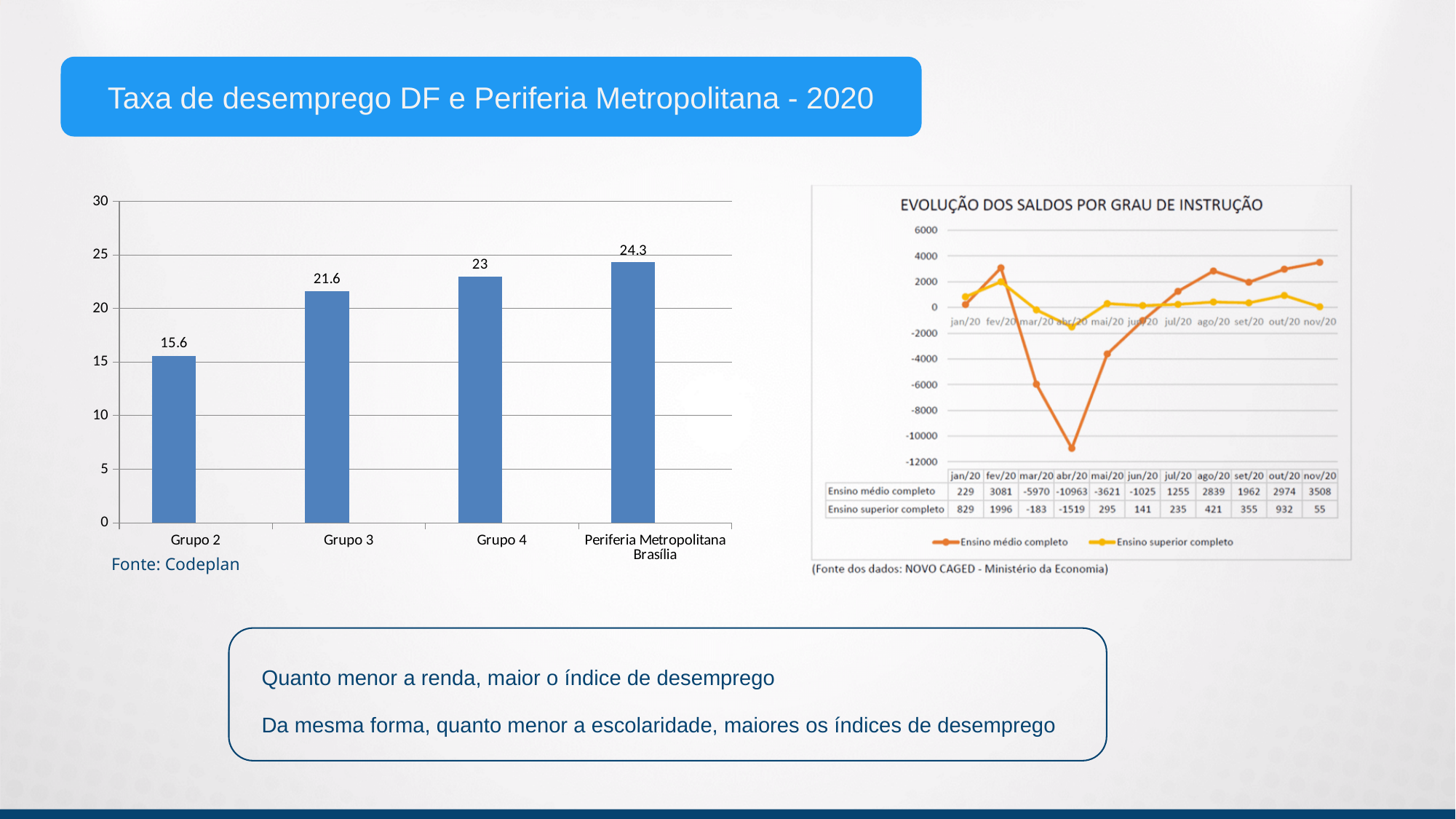
In the bar chart on the left, what is the difference between the values for Grupo 3 and Grupo 2? 6 In the chart titled 'EVOLUÇÃO DOS SALDOS POR GRAU DE INSTRUÇÃO', how many series does the legend list? 2 In the bar chart on the left, what is the value for Periferia Metropolitana Brasília? 24.3 In the chart titled 'EVOLUÇÃO DOS SALDOS POR GRAU DE INSTRUÇÃO', which series has the larger value in nov/20, Ensino médio completo or Ensino superior completo? Ensino médio completo In the chart titled 'EVOLUÇÃO DOS SALDOS POR GRAU DE INSTRUÇÃO', what is the value for Ensino superior completo in out/20? 932 In the bar chart on the left, which category has the lowest value? Grupo 2 In the bar chart on the left, which category has the highest value? Periferia Metropolitana Brasília In the chart titled 'EVOLUÇÃO DOS SALDOS POR GRAU DE INSTRUÇÃO', what is the value for Ensino médio completo in abr/20? -10963 In the bar chart on the left, what is the value for Grupo 2? 15.6 What kind of chart is the chart on the left? bar chart In the bar chart on the left, how many categories are shown? 4 In the bar chart on the left, do the values rise or fall from Grupo 2 to Periferia Metropolitana Brasília? rise